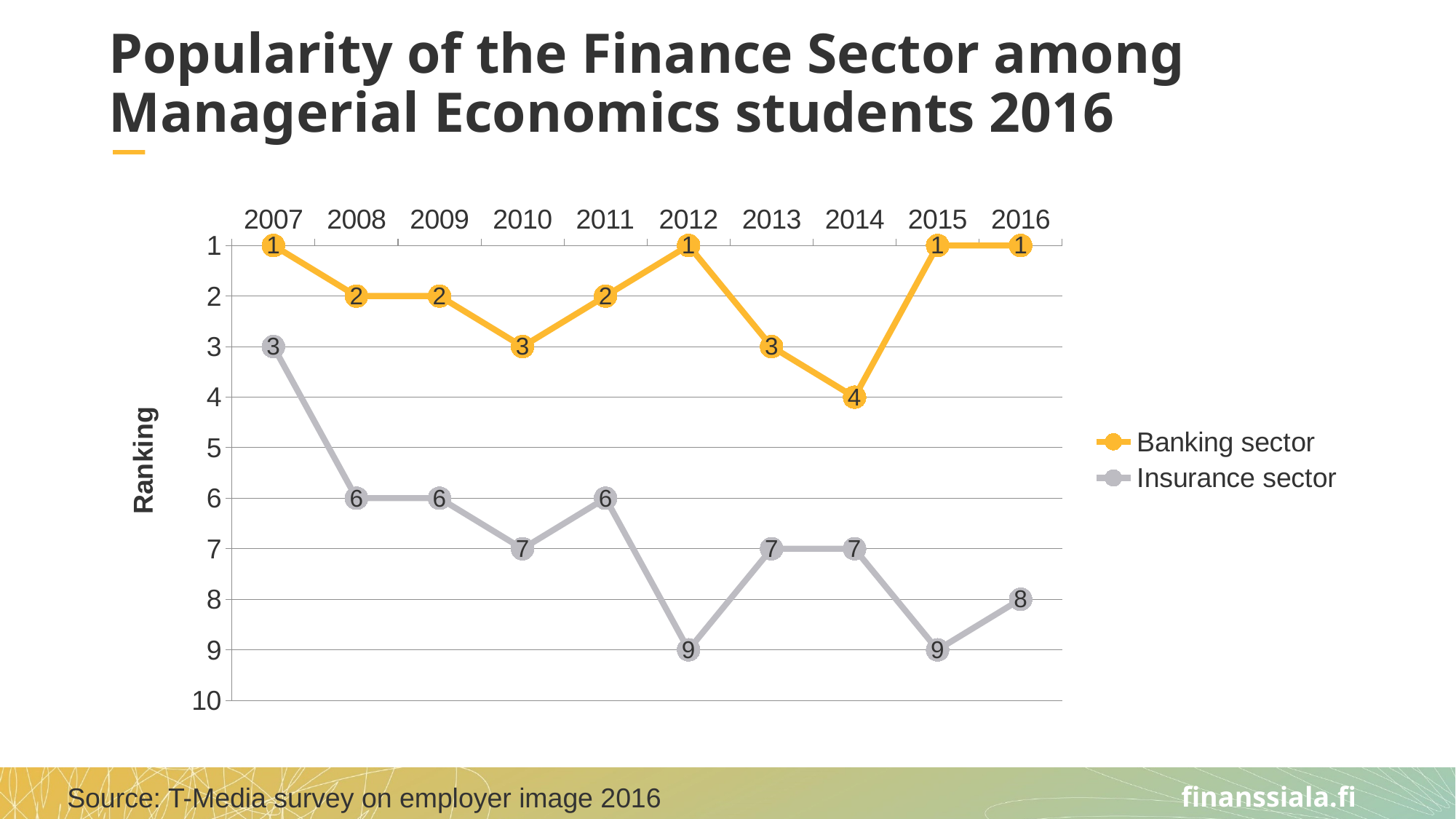
What type of chart is shown on the slide? Line chart Which series has the larger ranking number in 2008, Banking sector or Insurance sector? Insurance sector In which year does the Insurance sector have its smallest ranking number (best rank)? 2007 How many years are plotted on the x axis? 10 What is the difference between the Insurance sector ranking and the Banking sector ranking in 2012? 8 What is the ranking of the Banking sector in 2014? 4 What is the label of the y axis? Ranking In which year does the Banking sector have its largest ranking number (worst rank)? 2014 What is the ranking of the Insurance sector in 2016? 8 What is the ranking of the Insurance sector in 2012? 9 How many series does the legend list? 2 What is the ranking of the Banking sector in 2010? 3